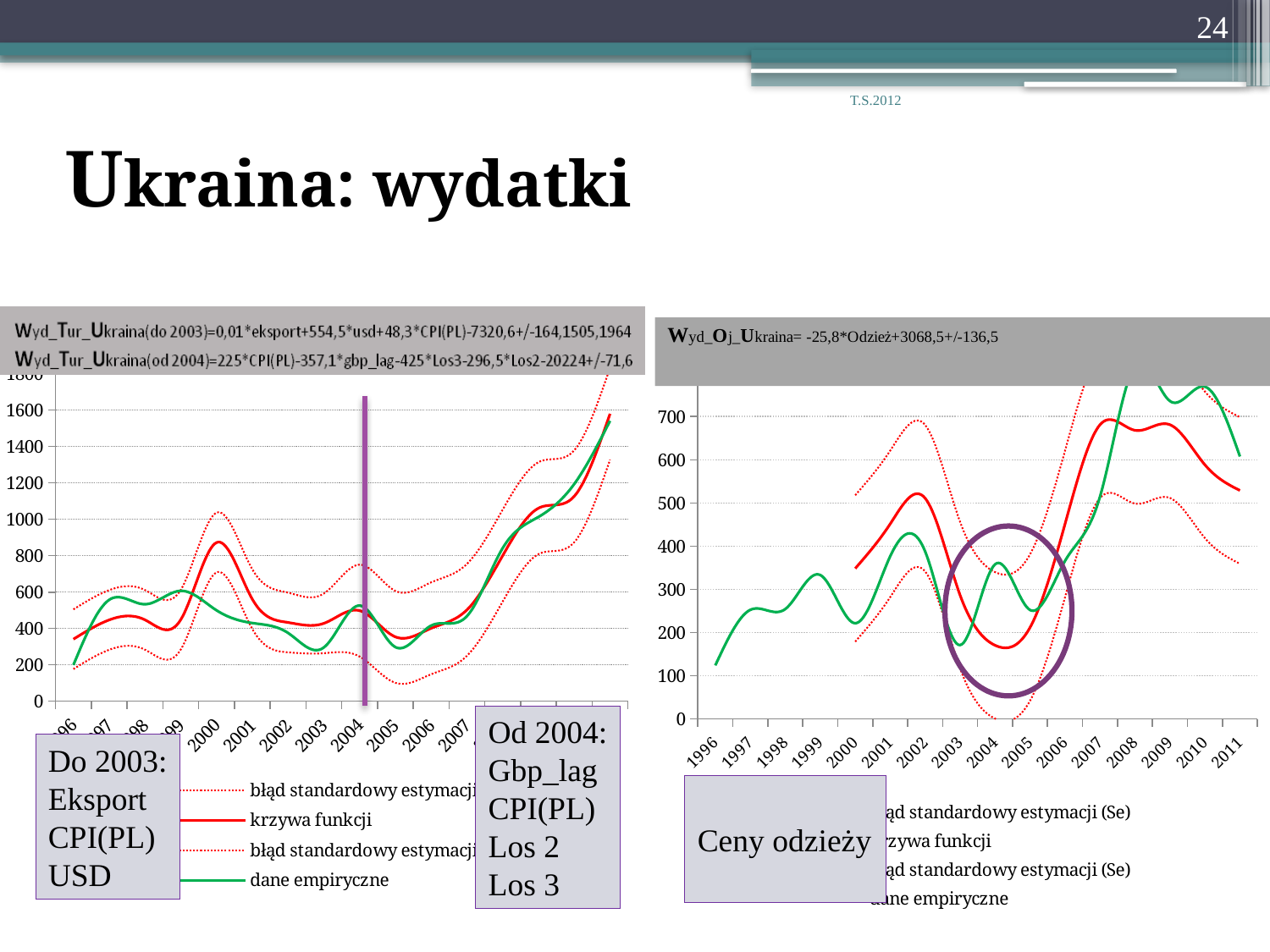
How many years are labelled on the x axis of the right chart (Wyd_Oj_Ukraina)? 16 How many entries does the legend of the left chart (Wyd_Tur_Ukraina) list? 4 In the right chart (Wyd_Oj_Ukraina), is the value of dane empiryczne in 1996 greater or less than 200? less What kind of chart is the left chart (Wyd_Tur_Ukraina)? line chart In the left chart (Wyd_Tur_Ukraina), what colour is the dane empiryczne line? green In the left chart (Wyd_Tur_Ukraina), is the value of dane empiryczne in 2011 greater or less than 1400? greater In the right chart (Wyd_Oj_Ukraina), is the value of krzywa funkcji in 2004 greater or less than 200? less In the right chart (Wyd_Oj_Ukraina), does the dane empiryczne line rise or fall between 2006 and 2008? rise What kind of chart is the right chart (Wyd_Oj_Ukraina)? line chart